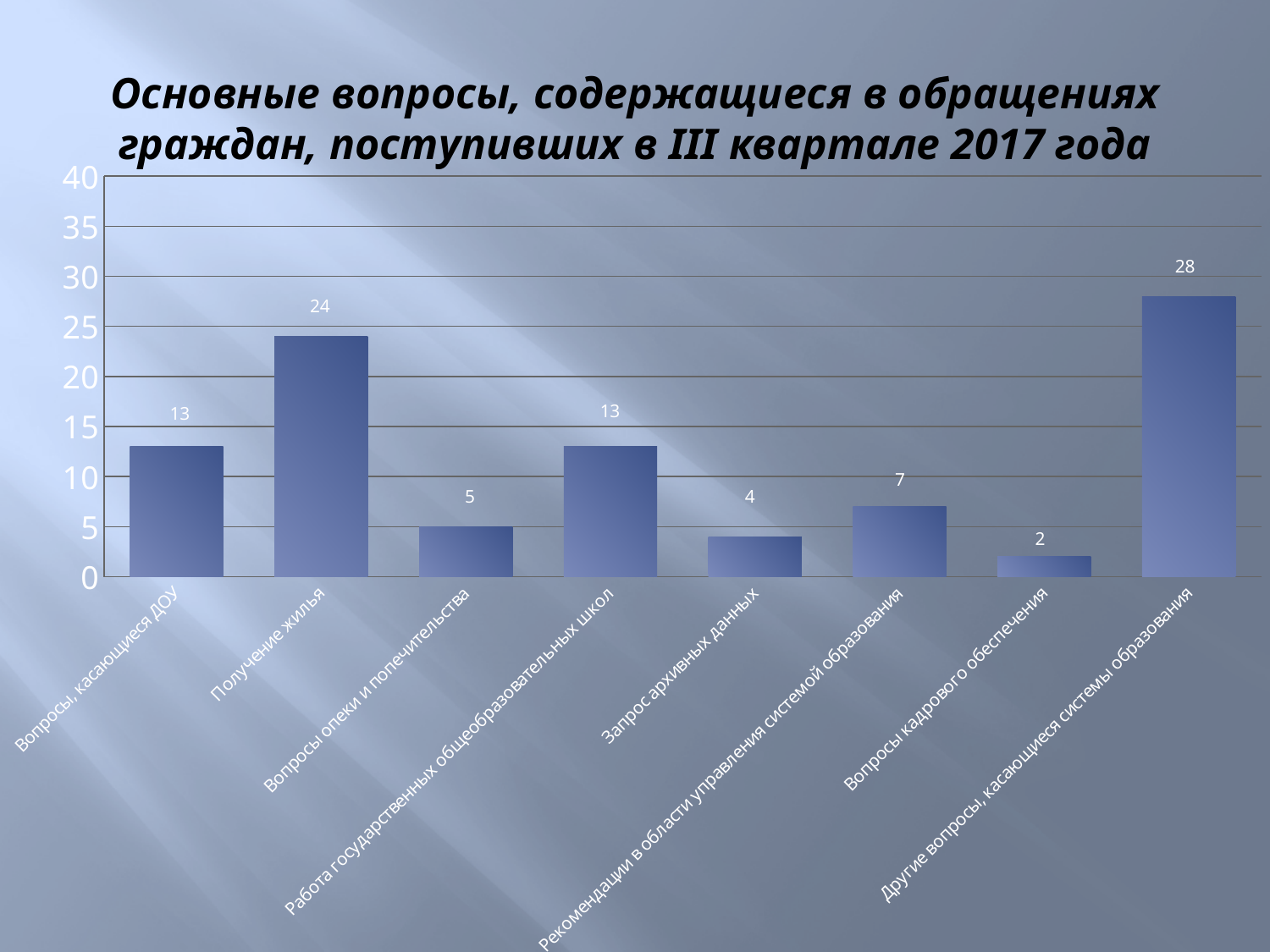
How many categories are shown in the chart? 8 Which category has the lowest value? Вопросы кадрового обеспечения Is the value for "Получение жилья" greater or less than 20? greater What value is shown for "Рекомендации в области управления системой образования"? 7 What kind of chart is shown on the slide? bar chart Which category has the highest value? Другие вопросы, касающиеся системы образования What value is shown for "Вопросы кадрового обеспечения"? 2 What is the title of the chart? Основные вопросы, содержащиеся в обращениях граждан, поступивших в III квартале 2017 года Which is larger: the value for "Вопросы опеки и попечительства" or the value for "Рекомендации в области управления системой образования"? Рекомендации в области управления системой образования What value is shown for "Получение жилья"? 24 What is the difference between the values for "Другие вопросы, касающиеся системы образования" and "Получение жилья"? 4 What value is shown for "Запрос архивных данных"? 4